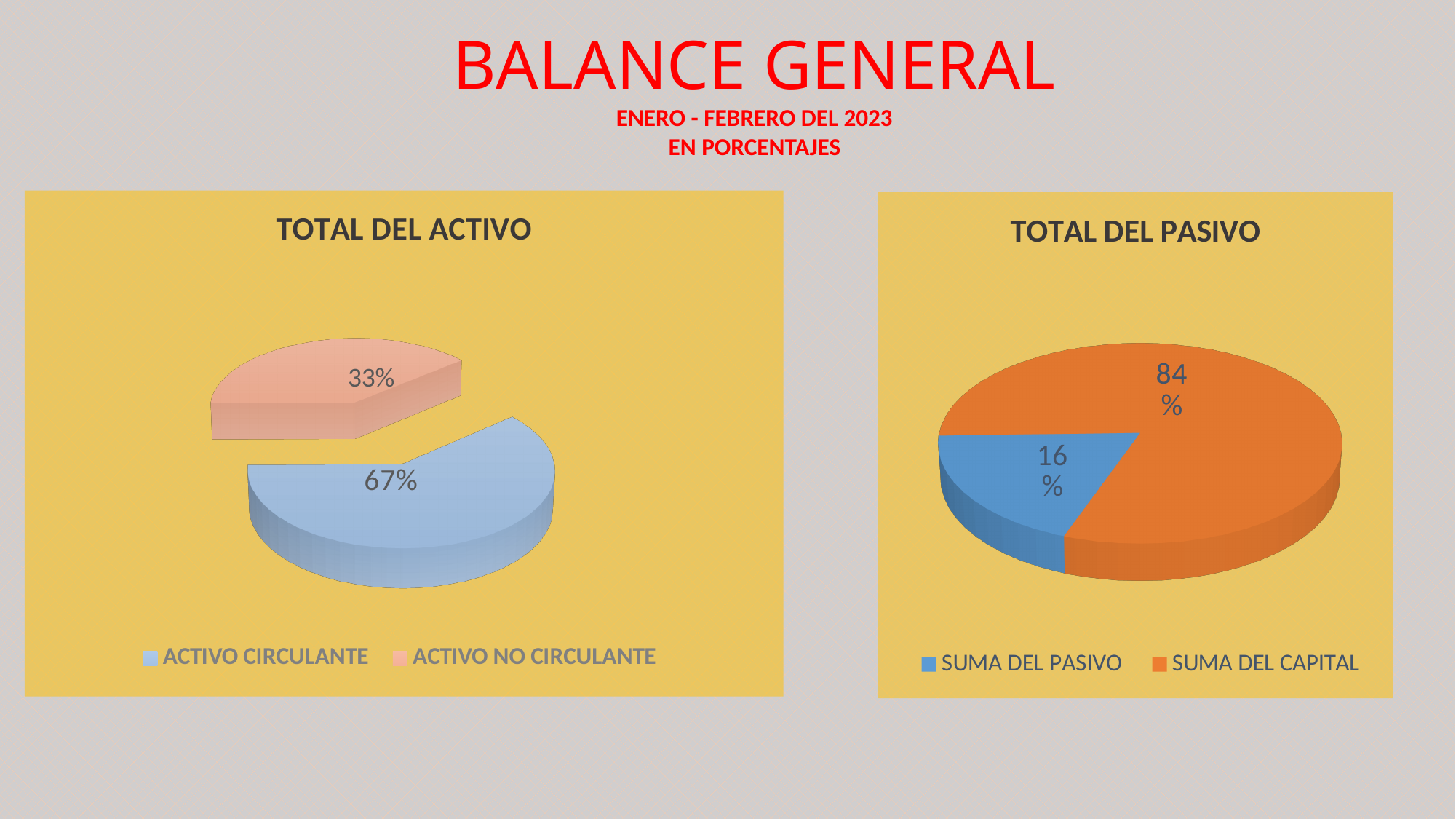
In the 'TOTAL DEL ACTIVO' chart, what share does ACTIVO CIRCULANTE have? 67% In the 'TOTAL DEL ACTIVO' chart, what colour is the ACTIVO NO CIRCULANTE slice? Peach/light orange In the 'TOTAL DEL PASIVO' chart, what share does SUMA DEL CAPITAL have? 84% In the 'TOTAL DEL PASIVO' chart, what is the difference in percentage points between SUMA DEL CAPITAL and SUMA DEL PASIVO? 68 In the 'TOTAL DEL ACTIVO' chart, what is the difference in percentage points between ACTIVO CIRCULANTE and ACTIVO NO CIRCULANTE? 34 What kind of chart is the 'TOTAL DEL ACTIVO' chart? Pie chart In the 'TOTAL DEL ACTIVO' chart, what share does ACTIVO NO CIRCULANTE have? 33% How many slices does the 'TOTAL DEL PASIVO' chart have? 2 In the 'TOTAL DEL PASIVO' chart, which category has the smallest slice? SUMA DEL PASIVO In the 'TOTAL DEL ACTIVO' chart, which category has the largest slice? ACTIVO CIRCULANTE In the 'TOTAL DEL PASIVO' chart, which is larger, SUMA DEL PASIVO or SUMA DEL CAPITAL? SUMA DEL CAPITAL